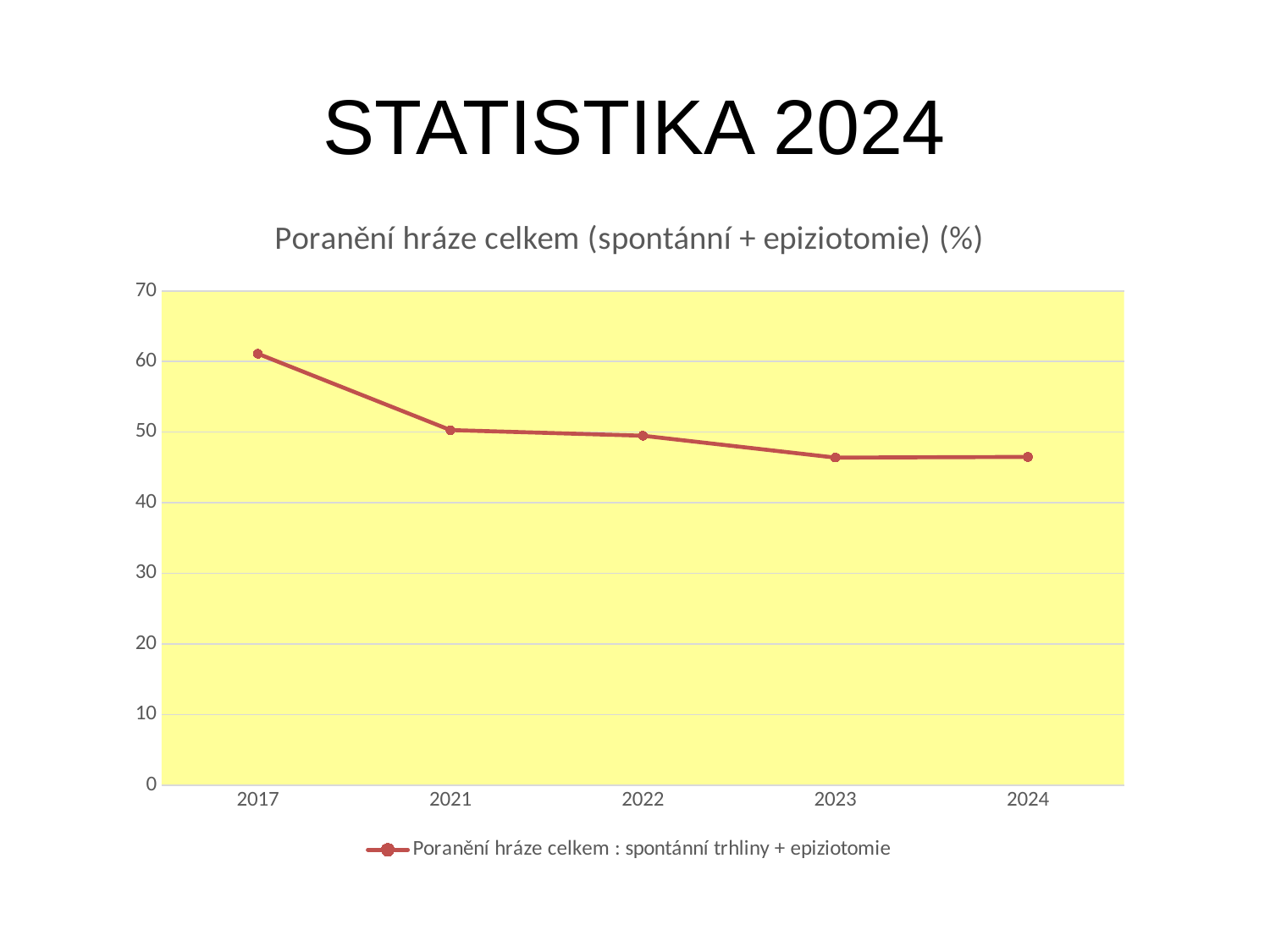
Is the value for 2024 greater or less than 40? greater Which is larger, the value for 2017 or the value for 2024? 2017 How many years are plotted on the x axis? 5 Is the value for 2023 greater or less than 50? less Do the values rise or fall from 2017 to 2024? fall Which year has the highest value? 2017 What is the legend entry for the plotted series? Poranění hráze celkem : spontánní trhliny + epiziotomie What kind of chart is shown on the slide? line chart Is the value for 2017 greater or less than 50? greater Which is larger, the value for 2021 or the value for 2023? 2021 How many series does the legend list? 1 What is the title of the chart? Poranění hráze celkem (spontánní + epiziotomie) (%)